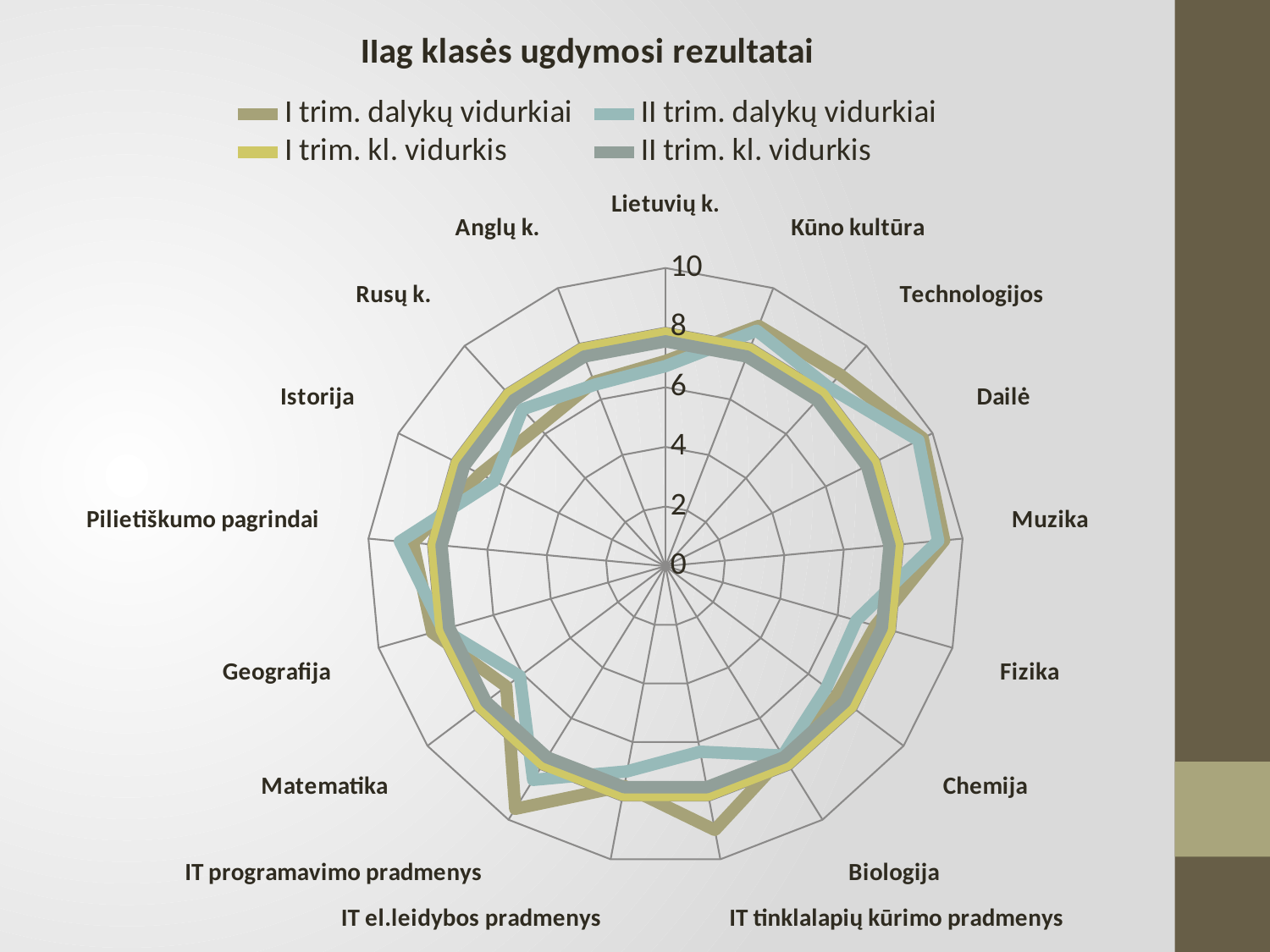
Is the value for Biologija in the I trim. dalykų vidurkiai series greater or less than 8? less Is the value for Matematika in the II trim. dalykų vidurkiai series greater or less than 4? greater Is the value for Kūno kultūra in the I trim. dalykų vidurkiai series greater or less than 8? greater What is the title of the chart? IIag klasės ugdymosi rezultatai What is the highest value shown on the chart's axis scale? 10 How many series does the legend list? 4 How many subject categories (axes) does the radar chart have? 17 What kind of chart is shown on the slide? radar chart